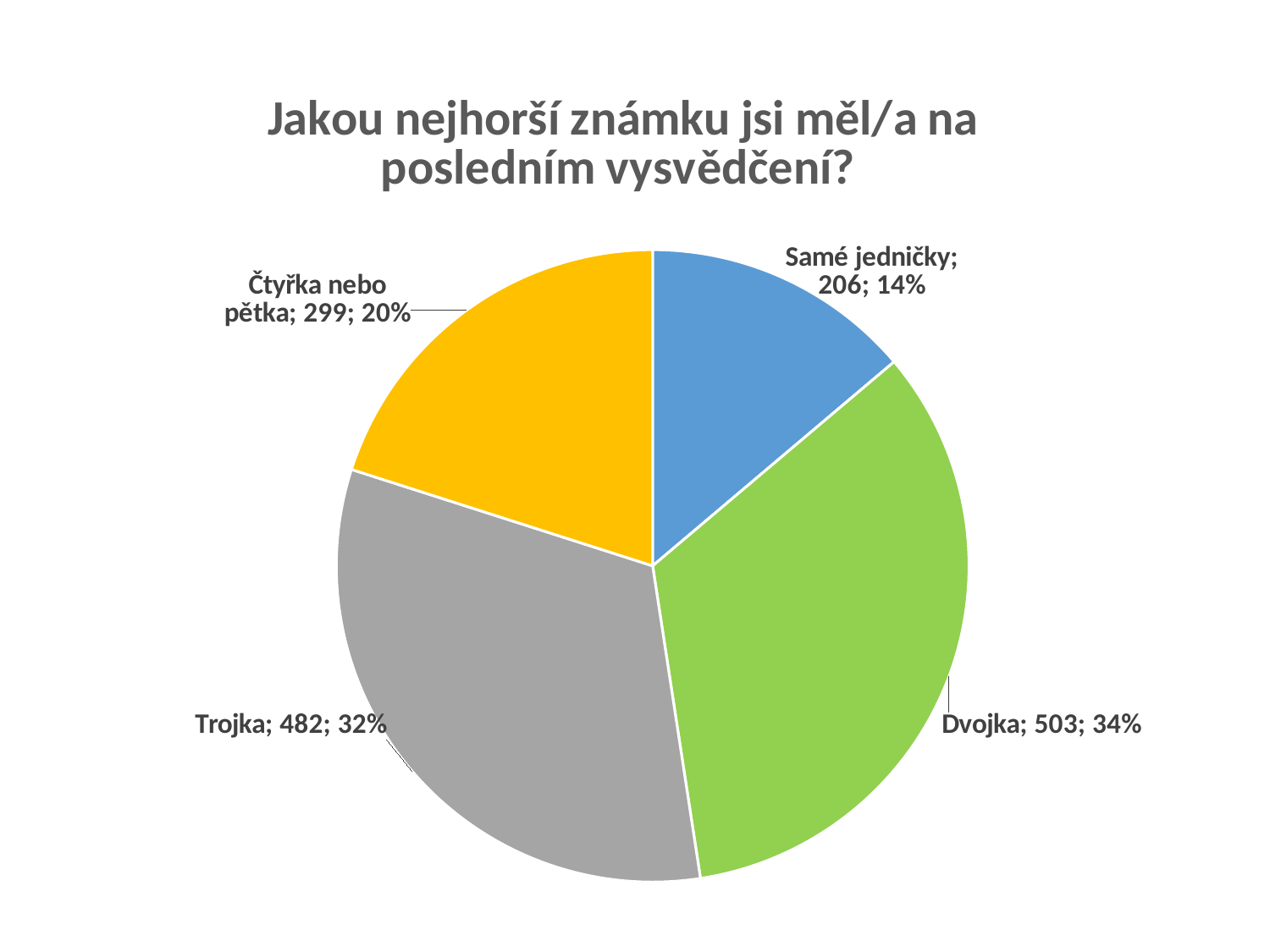
What is the title of the chart? Jakou nejhorší známku jsi měl/a na posledním vysvědčení? What is the value for Čtyřka nebo pětka? 299 What kind of chart is shown on the slide? pie chart What is the value for Samé jedničky? 206 What is the value for Trojka? 482 Which category has the lowest value? Samé jedničky What share of the pie does Samé jedničky represent? 14% Which category has the highest value? Dvojka What is the value for Dvojka? 503 What share of the pie does Trojka represent? 32% What is the difference between the values for Dvojka and Samé jedničky? 297 How many slices does the pie chart have? 4